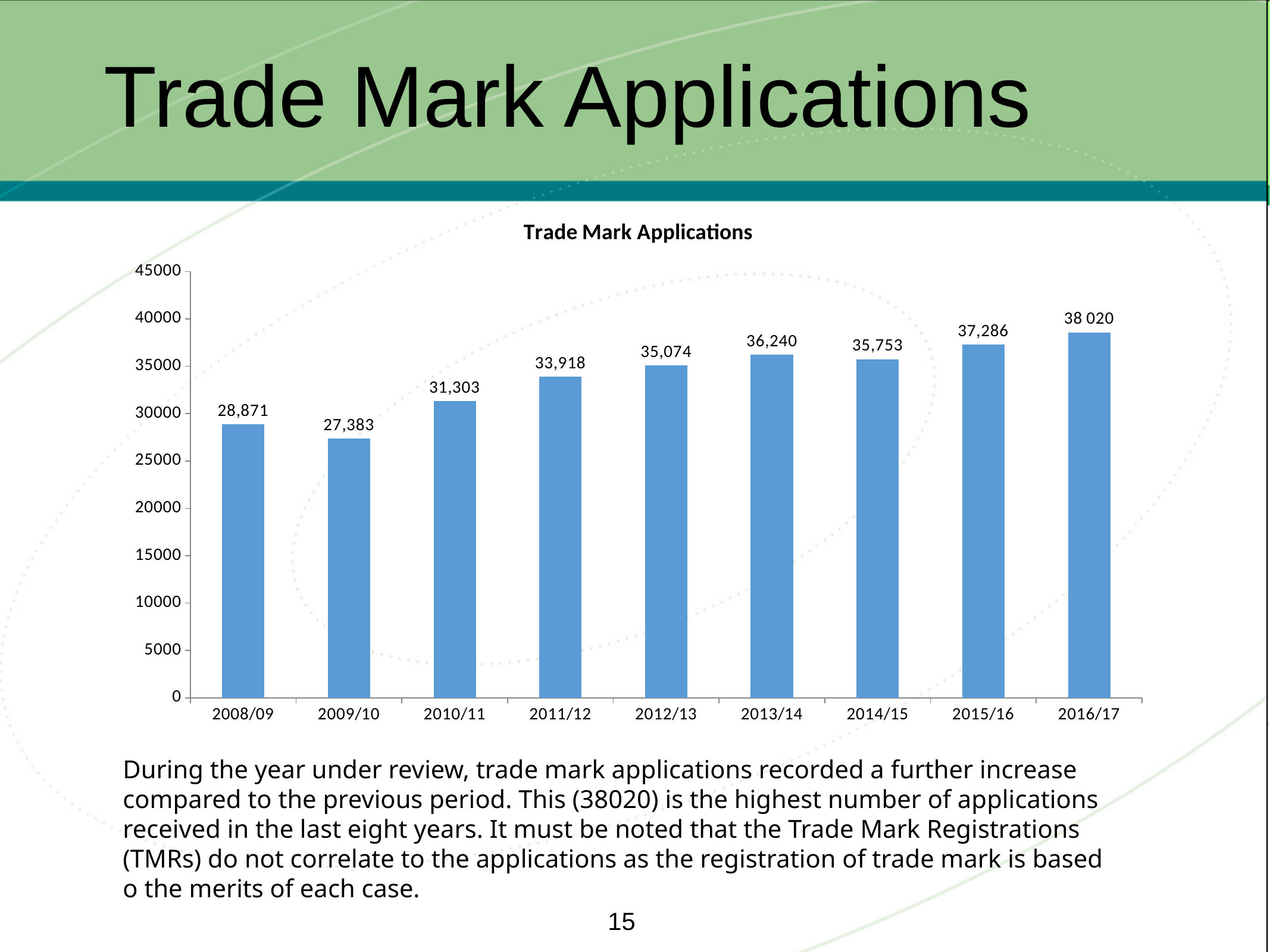
What is the value for 2008/09? 28,871 Which year has the highest number of trade mark applications? 2016/17 What is the difference between the values for 2010/11 and 2009/10? 3,920 What is the difference between the values for 2015/16 and 2014/15? 1,533 Which year has the lowest number of trade mark applications? 2009/10 What is the value for 2012/13? 35,074 How many years are shown on the x axis? 9 What kind of chart is shown on the slide? bar chart Which is larger, the value for 2013/14 or the value for 2014/15? 2013/14 What is the value for 2016/17? 38 020 What is the title of the chart? Trade Mark Applications Is the value for 2011/12 greater or less than 35000? less